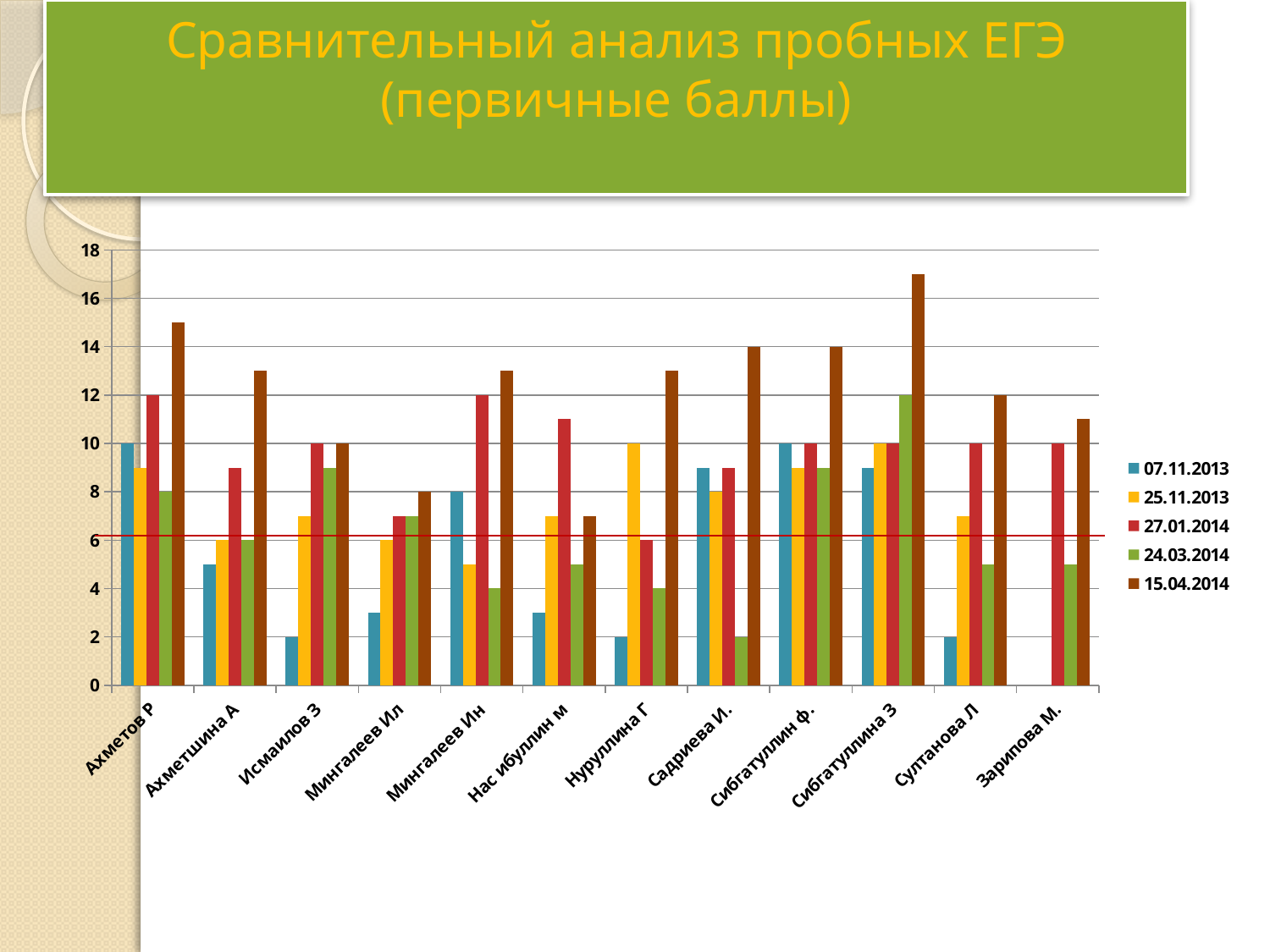
In the 15.04.2014 series, which is larger: Ахметов Р or Ахметшина А? Ахметов Р Which student has the lowest value in the 15.04.2014 series? Нас ибуллин м Is the value for Сибгатуллина З in the 15.04.2014 series greater or less than 16? greater What kind of chart is shown on the slide? bar chart What is the value for Ахметов Р in the 27.01.2014 series? 12 What is the difference between Ахметов Р's 27.01.2014 value and his 07.11.2013 value? 2 How many students (categories) are shown on the x axis? 12 How many series does the legend list? 5 Which student has the highest value in the 15.04.2014 series? Сибгатуллина З What is the value for Сибгатуллина З in the 24.03.2014 series? 12 What is the value for Садриева И. in the 15.04.2014 series? 14 What is the value for Ахметов Р in the 07.11.2013 series? 10